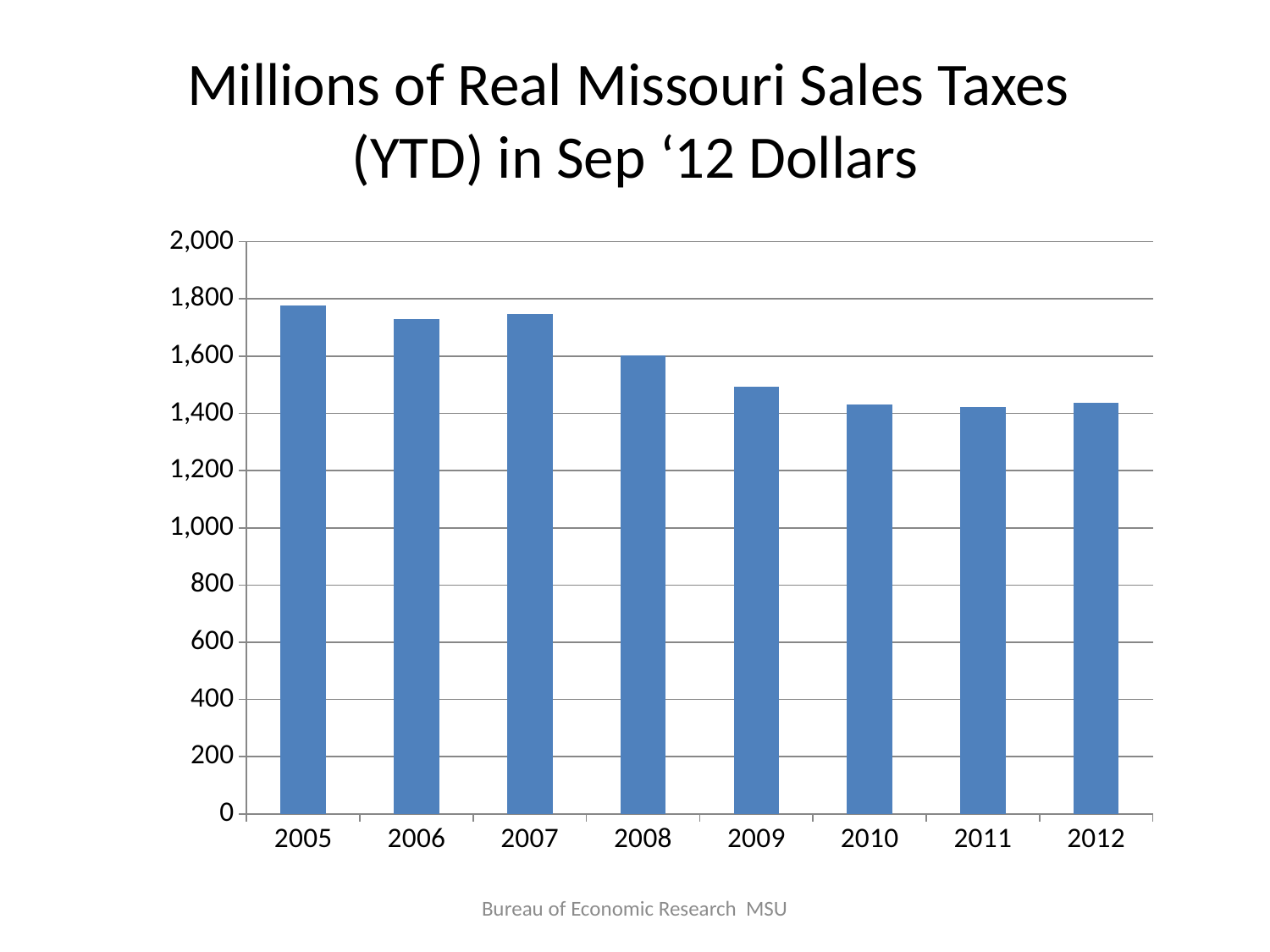
Do the values generally rise or fall from 2005 to 2012? fall How many years are shown on the x axis of the chart? 8 What kind of chart is shown on the slide? Bar chart Is the value for 2012 greater or less than 1,600? less Is the value for 2010 greater or less than 1,400? greater Is the value for 2009 greater or less than 1,600? less What is the title of the chart on the slide? Millions of Real Missouri Sales Taxes (YTD) in Sep '12 Dollars Which is larger, the value for 2005 or the value for 2008? 2005 Which year has the highest bar in the chart? 2005 Which is larger, the value for 2008 or the value for 2009? 2008